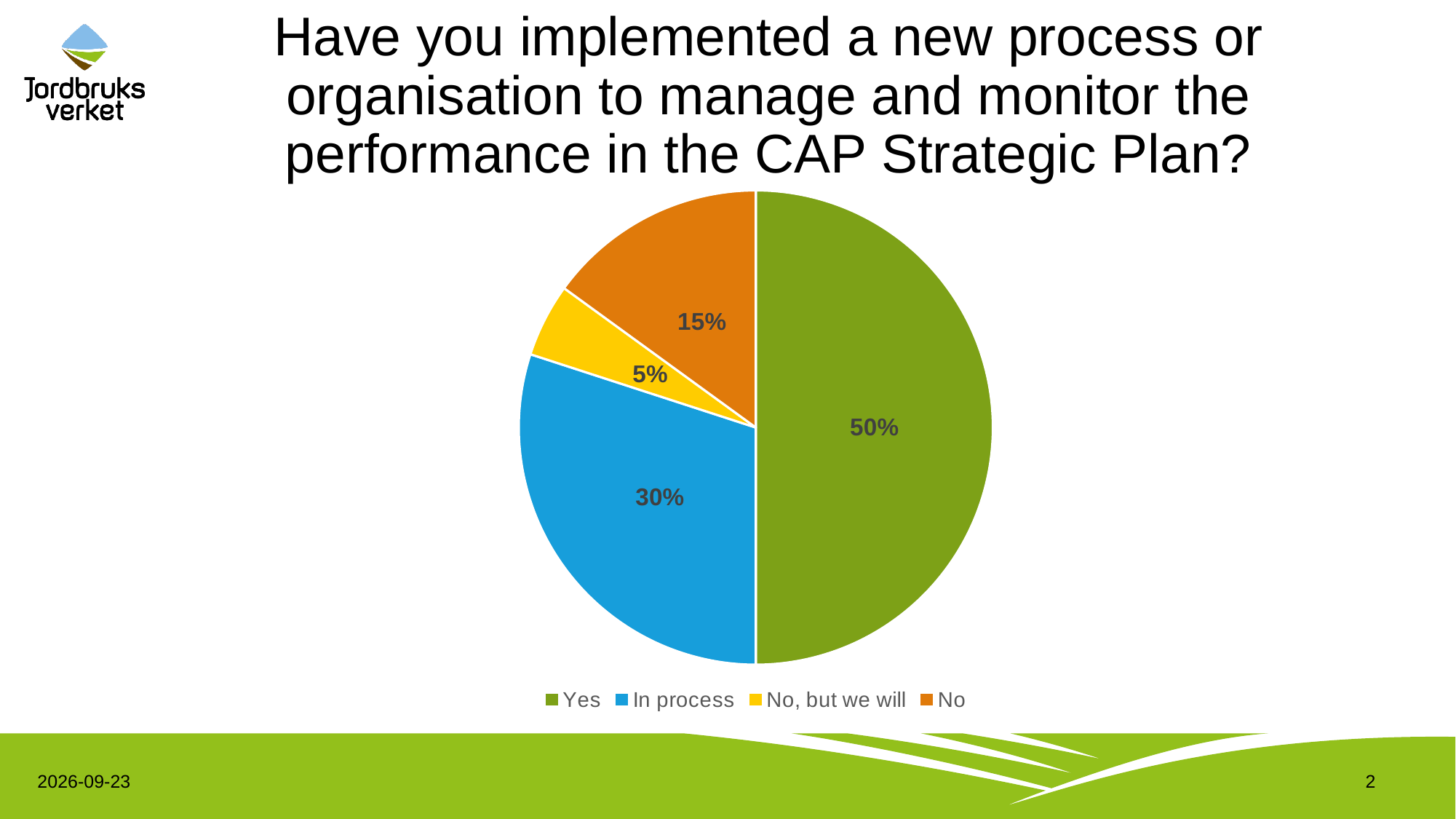
Which colour represents the "In process" category in the legend? Blue What share of the pie is labelled "In process"? 30% Which category has the smallest slice of the pie? No, but we will What is the difference in percentage points between the "Yes" slice and the "In process" slice? 20 percentage points How many categories does the pie chart show? 4 What is the combined share of the "No" and "No, but we will" slices? 20% Which category has the largest slice of the pie? Yes What share of the pie is labelled "Yes"? 50% What share of the pie is labelled "No"? 15% What share of the pie is labelled "No, but we will"? 5% Which slice is larger, "No" or "No, but we will"? No What kind of chart is shown on the slide? Pie chart